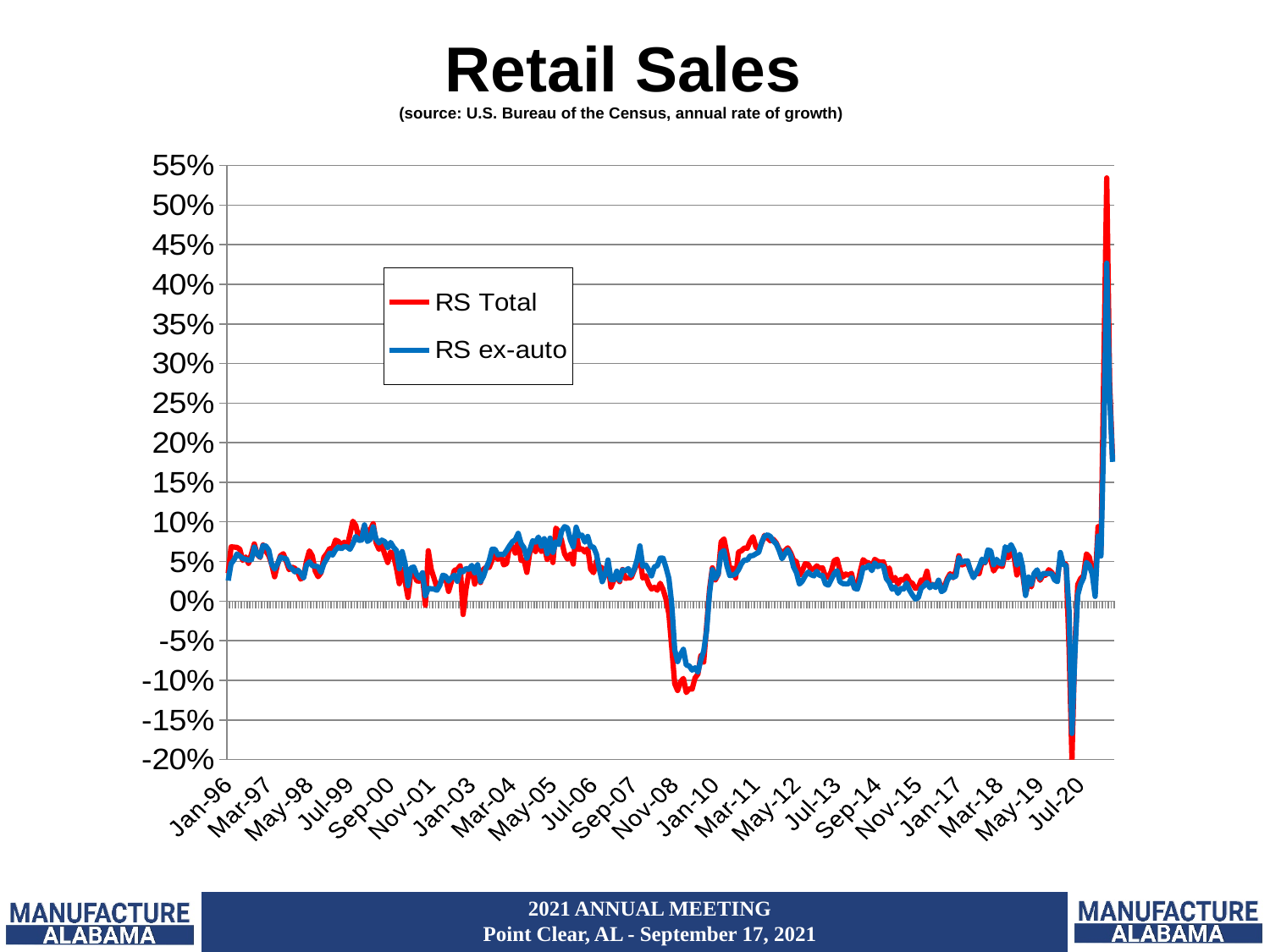
What is the highest value shown on the y axis? 55% What kind of chart is shown on the slide? line chart Which series reaches the highest value on the chart? RS Total Is the peak value of RS ex-auto in 2021 greater or less than 40%? greater What are the two series named in the legend? RS Total and RS ex-auto Is the peak value of RS Total in 2021 greater or less than 50%? greater How many series does the legend list? 2 How many date labels are shown on the x axis? 22 At the 2021 spike, which series is higher, RS Total or RS ex-auto? RS Total Is the lowest value of RS Total in 2020 greater or less than -15%? less Which colour is used for the RS ex-auto series? blue